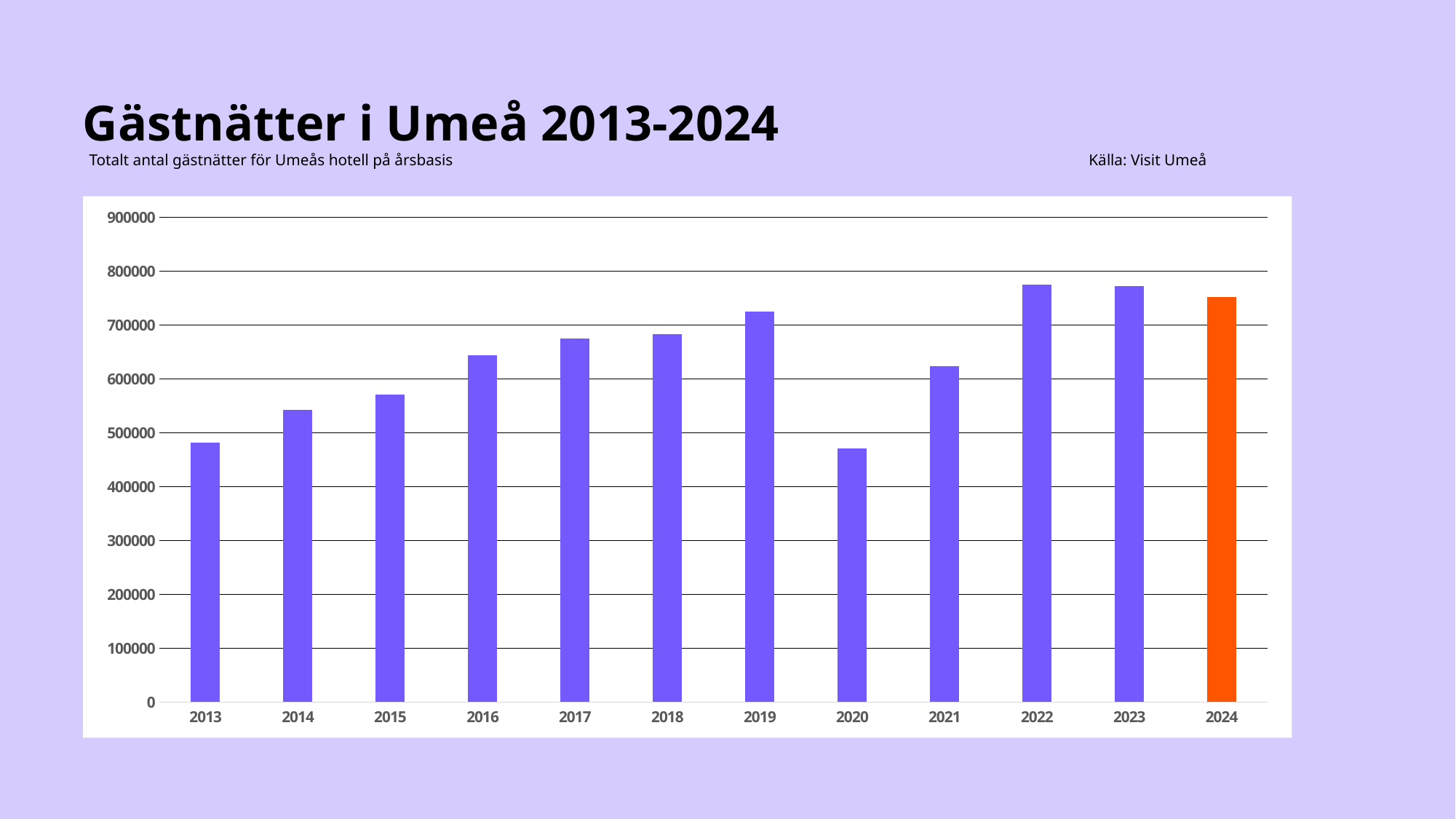
Which year has the larger value, 2016 or 2015? 2016 Is the value for 2013 greater or less than 500000? less What kind of chart is shown on the slide? bar chart Is the value for 2020 greater or less than 500000? less Is the value for 2022 greater or less than 800000? less Which year has the larger value, 2019 or 2020? 2019 Which year's bar is shown in orange instead of purple? 2024 Do the values rise or fall from 2013 to 2019? rise How many years (bars) are shown in the chart? 12